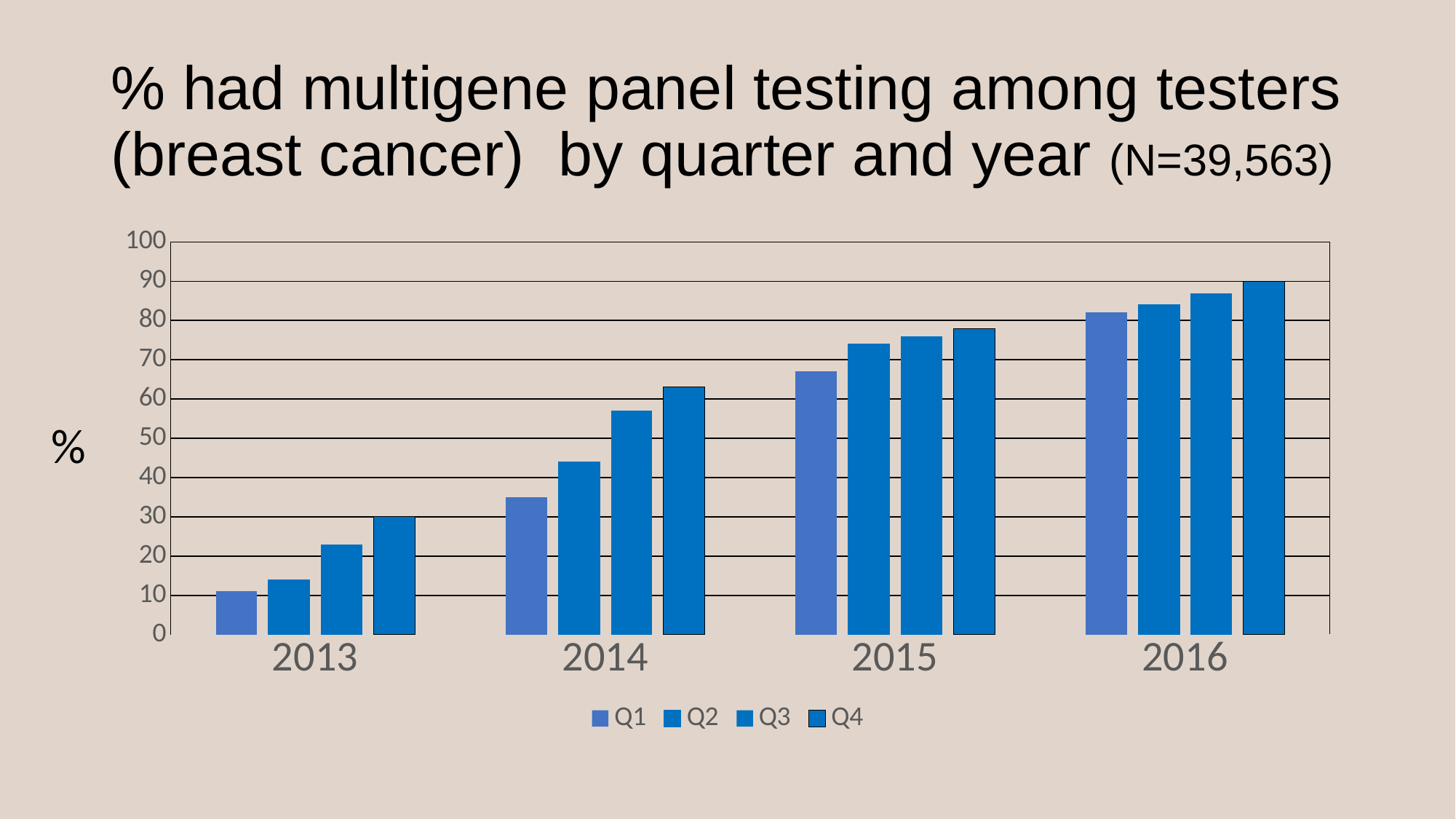
Which year and quarter has the highest value? Q4 2016 Is the value for Q1 2013 greater or less than 20? less Is the value for Q2 2015 greater or less than 70? greater How many years are shown along the x axis? 4 Which year and quarter has the lowest value? Q1 2013 What kind of chart is shown on the slide? bar chart Which is larger, the value for Q4 2014 or the value for Q1 2015? Q1 2015 What sample size (N) is given in the chart title? N=39,563 Is the value for Q4 2016 greater or less than 80? greater Do the values rise or fall from 2013 to 2016? rise How many series does the legend list? 4